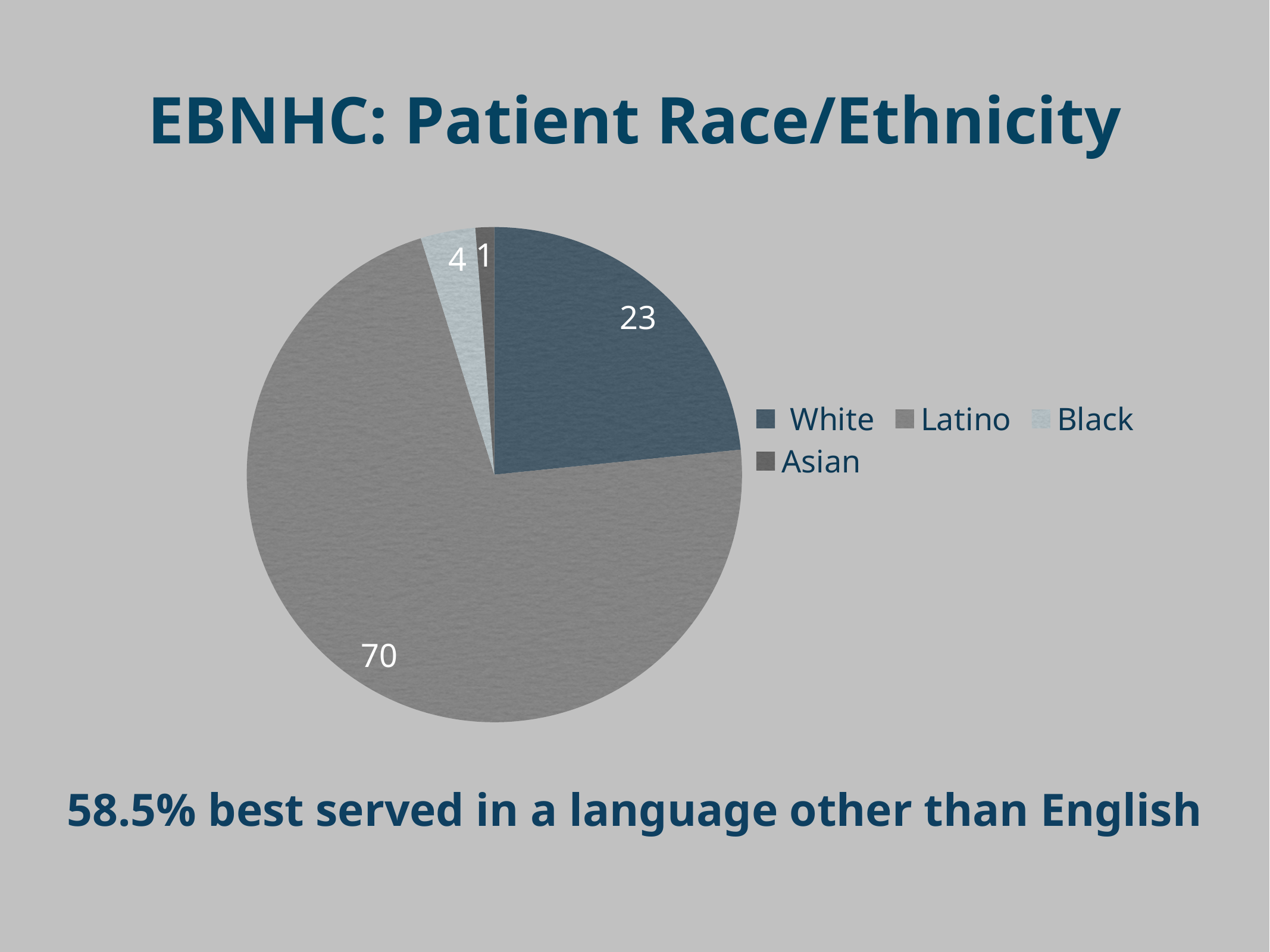
What is the value for Black in the pie chart? 4 What is the title of the chart on the slide? EBNHC: Patient Race/Ethnicity What kind of chart is shown on the slide? Pie chart What is the value for White in the pie chart? 23 How many categories does the pie chart show? 4 What is the value for Asian in the pie chart? 1 Which is larger, the value for White or the value for Black? White Which category has the largest slice of the pie chart? Latino What is the value for Latino in the pie chart? 70 What is the difference between the Latino and White values? 47 Which category has the smallest slice of the pie chart? Asian Which legend entry is shown with the lightest colour? Black